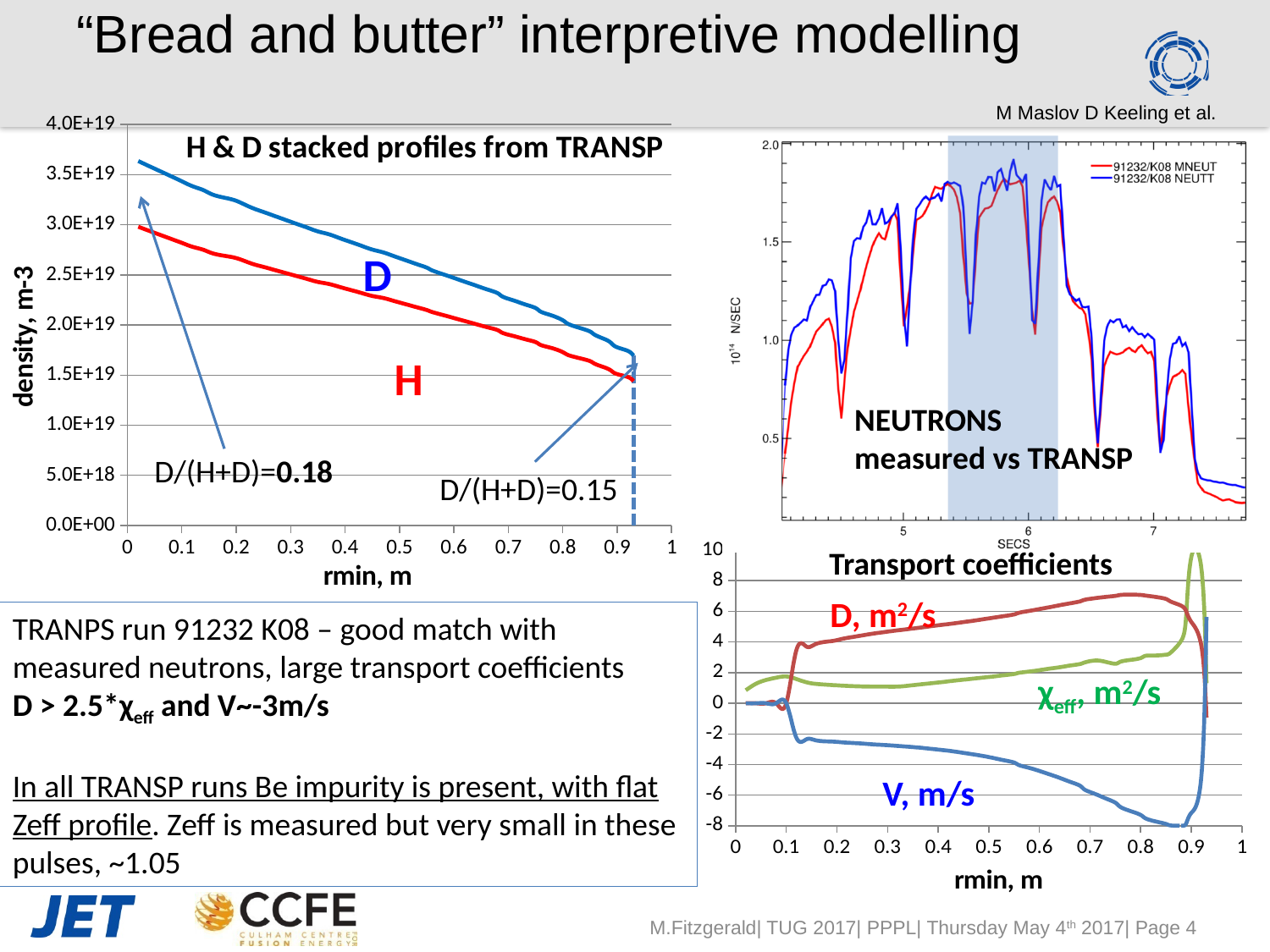
What kind of chart is the 'H & D stacked profiles from TRANSP' chart? line chart In the 'H & D stacked profiles from TRANSP' chart, do the D and H densities rise or fall as rmin increases? fall In the 'H & D stacked profiles from TRANSP' chart, what is the annotated value of D/(H+D) at the edge (rmin near 0.9)? 0.15 In the 'H & D stacked profiles from TRANSP' chart, how many series are plotted? 3 In the 'H & D stacked profiles from TRANSP' chart, what is the annotated value of D/(H+D) at the core (rmin near 0)? 0.18 In the 'Transport coefficients' chart, is the value of V at rmin = 0.8 greater or less than -6? less In the 'H & D stacked profiles from TRANSP' chart, is the D value at rmin = 0 greater or less than 3.5E+19? greater What is the x-axis label of the 'H & D stacked profiles from TRANSP' chart? rmin, m In the 'H & D stacked profiles from TRANSP' chart, is the H value at rmin = 0.5 greater or less than 2.0E+19? greater In the 'NEUTRONS measured vs TRANSP' chart, how many series does the legend list? 2 In the 'Transport coefficients' chart, which series has the highest value at rmin = 0.5? D, m2/s